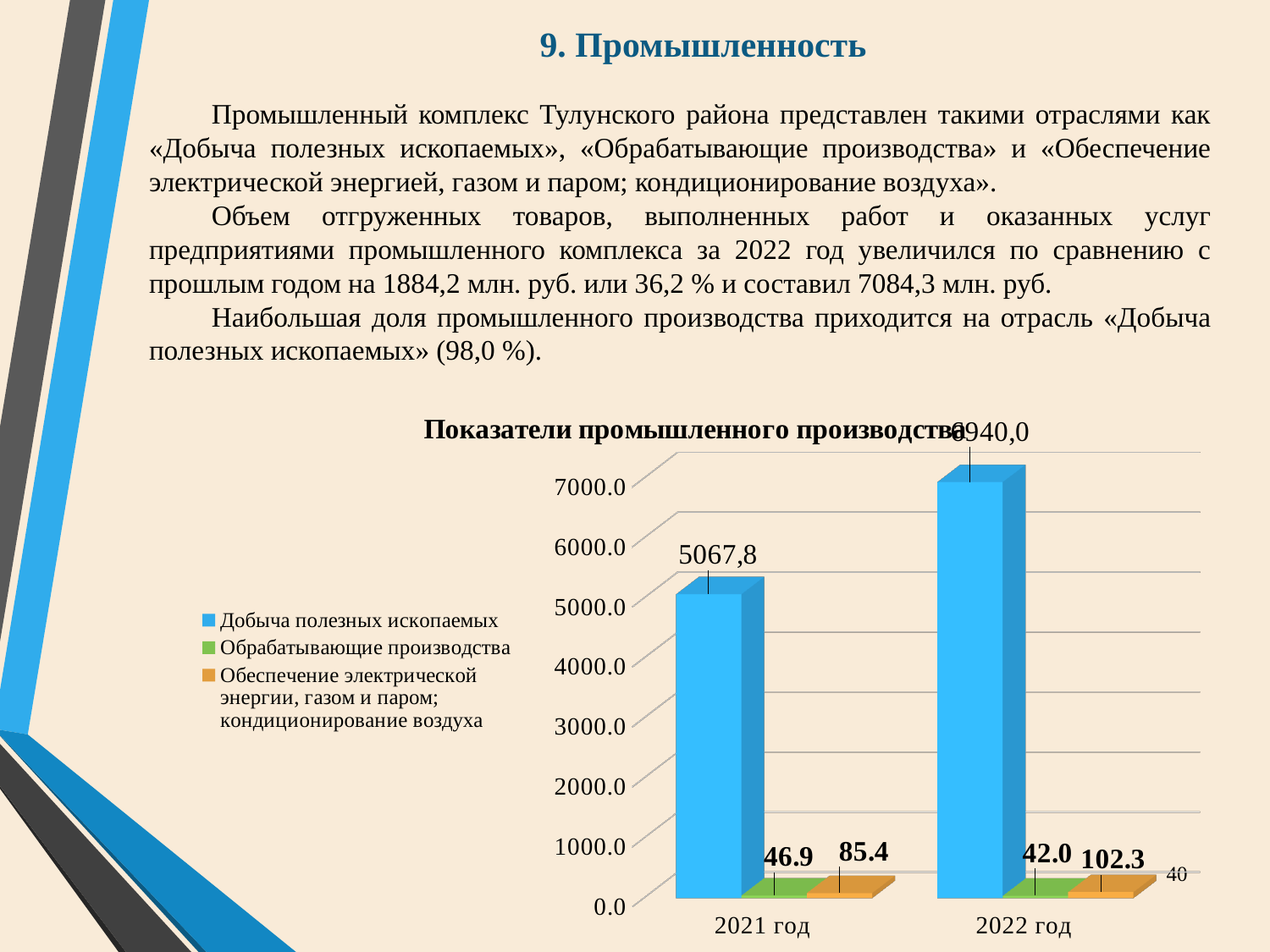
Which series has the lowest value in 2021 год? Обрабатывающие производства What is the value for «Добыча полезных ископаемых» in 2022 год? 6940,0 What is the value for «Добыча полезных ископаемых» in 2021 год? 5067,8 How many series does the legend list? 3 What is the value for «Обрабатывающие производства» in 2021 год? 46.9 Which series has the highest value in 2022 год? Добыча полезных ископаемых Is the value for «Обрабатывающие производства» larger in 2021 год or in 2022 год? 2021 год How many categories are shown on the x axis? 2 Does the value for «Добыча полезных ископаемых» rise or fall from 2021 год to 2022 год? rise What is the value for «Обеспечение электрической энергии, газом и паром; кондиционирование воздуха» in 2022 год? 102.3 What type of chart is shown on the slide? bar chart What is the value for «Обрабатывающие производства» in 2022 год? 42.0